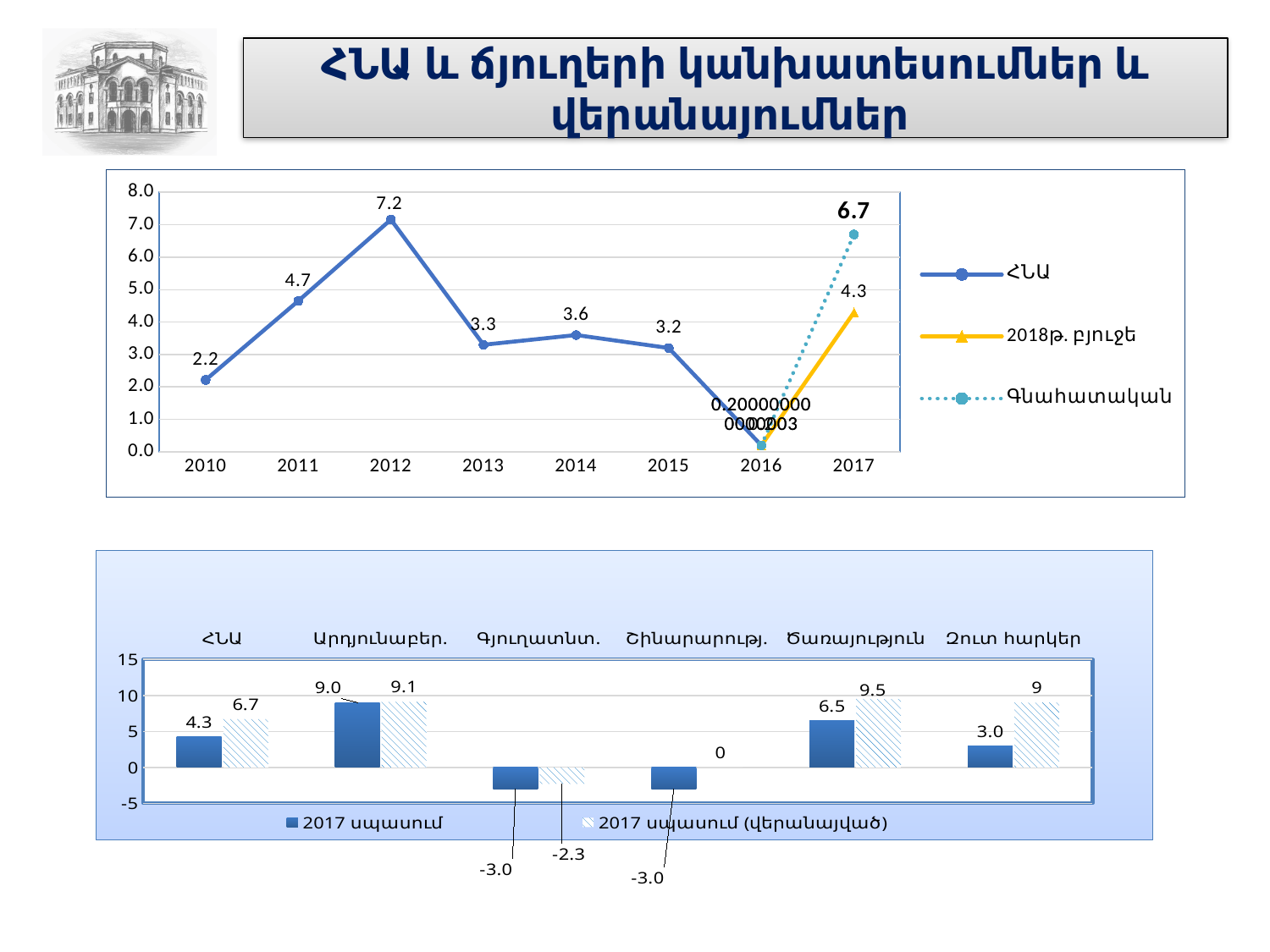
How many series does the legend of the top chart list? 3 In the top chart, does the ՀՆԱ line rise or fall from 2012 to 2013? fall How many categories are shown in the bottom chart? 6 In the top chart, what is the ՀՆԱ value for 2012? 7.2 In the top chart, what is the difference between the ՀՆԱ values for 2011 and 2010? 2.5 In the bottom chart, what is the 2017 սպասում value for Գյուղատնտ.? -3.0 In the top chart, what is the Գնահատական value for 2017? 6.7 In the top chart, what is the ՀՆԱ value for 2010? 2.2 In the top chart, what is the 2018թ. բյուջե value for 2017? 4.3 In the top chart, which year has the highest ՀՆԱ value? 2012 What kind of chart is the bottom chart? bar chart In the bottom chart, what is the 2017 սպասում (վերանայված) value for Ծառայություն? 9.5